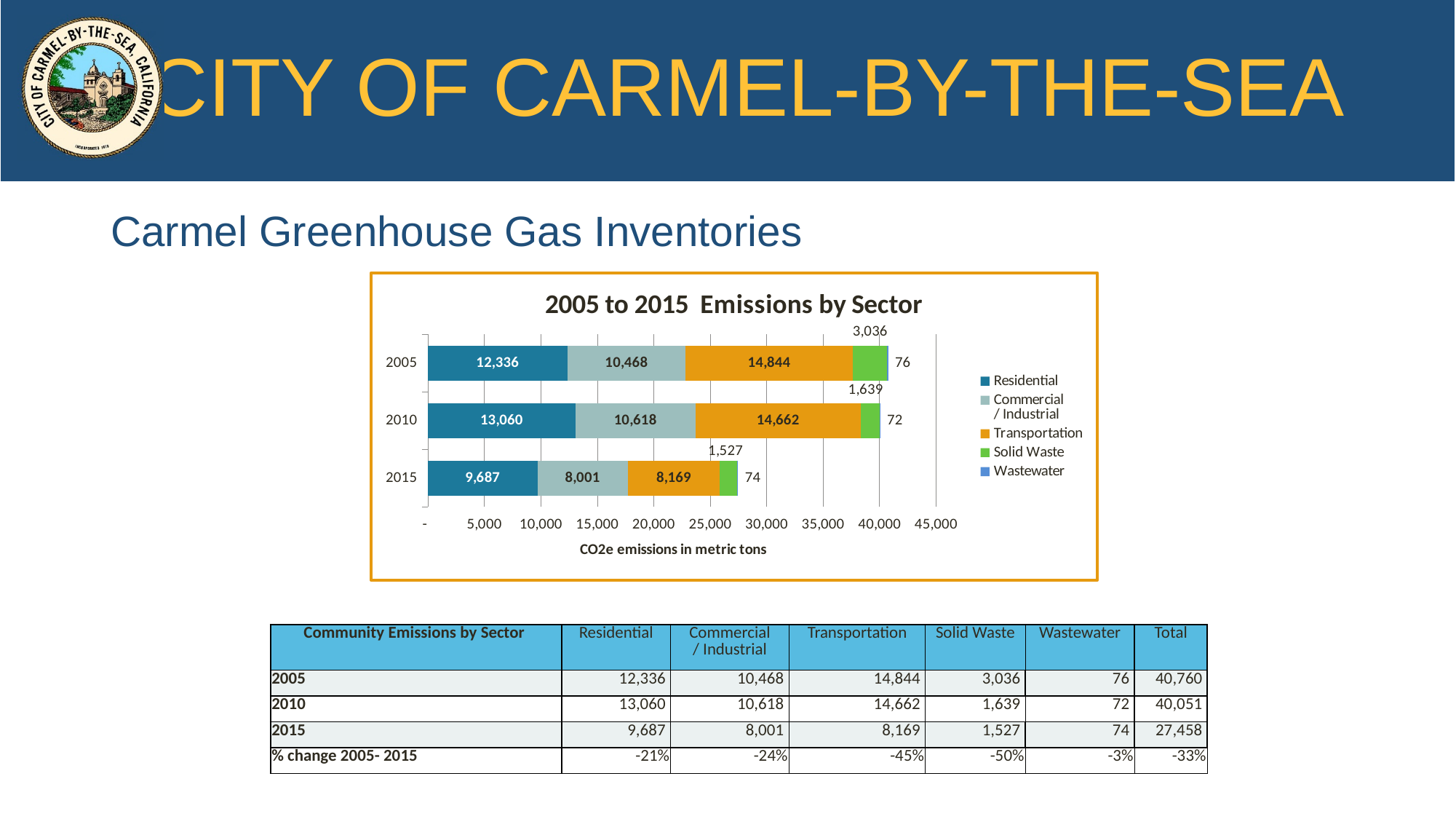
What type of chart is shown on the slide? Stacked bar chart Which year has the highest Transportation emissions in the chart? 2005 What is the difference between Commercial / Industrial emissions in 2010 and 2015? 2,617 Which is larger: Residential emissions in 2005 or in 2010? 2010 How many series does the chart legend list? 5 What is the Transportation emissions value for 2015 in the chart? 8,169 What is the total of the stacked bar for 2015? 27,458 What is the Solid Waste emissions value for 2010 in the chart? 1,639 What is the x-axis label of the chart? CO2e emissions in metric tons What is the Residential emissions value for 2005 in the chart? 12,336 Which year has the lowest Residential emissions in the chart? 2015 What is the Wastewater emissions value for 2015 in the chart? 74